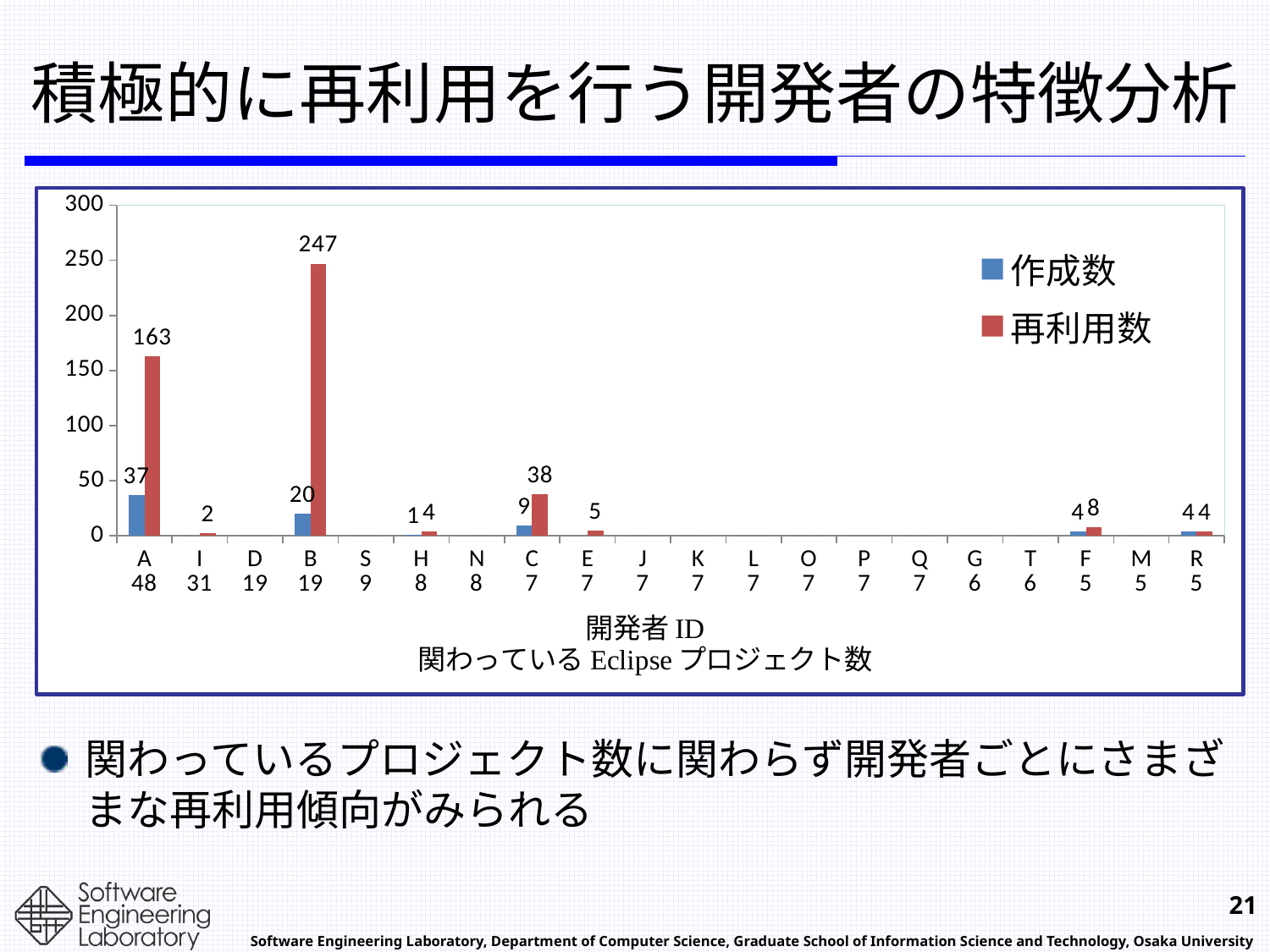
Which is larger, the 再利用数 for developer A or for developer C? developer A Which developer has the highest 再利用数? B How many developer IDs are shown on the x axis? 20 Is the 再利用数 value for developer A greater or less than 150? greater What type of chart is shown on the slide? bar chart How many series does the legend list? 2 What is the 再利用数 value for developer C? 38 Which developer has the highest 作成数? A What is the 作成数 value for developer A? 37 What is the difference between the 再利用数 of developer B and developer A? 84 What is the 再利用数 value for developer B? 247 What are the two series names shown in the legend? 作成数 and 再利用数